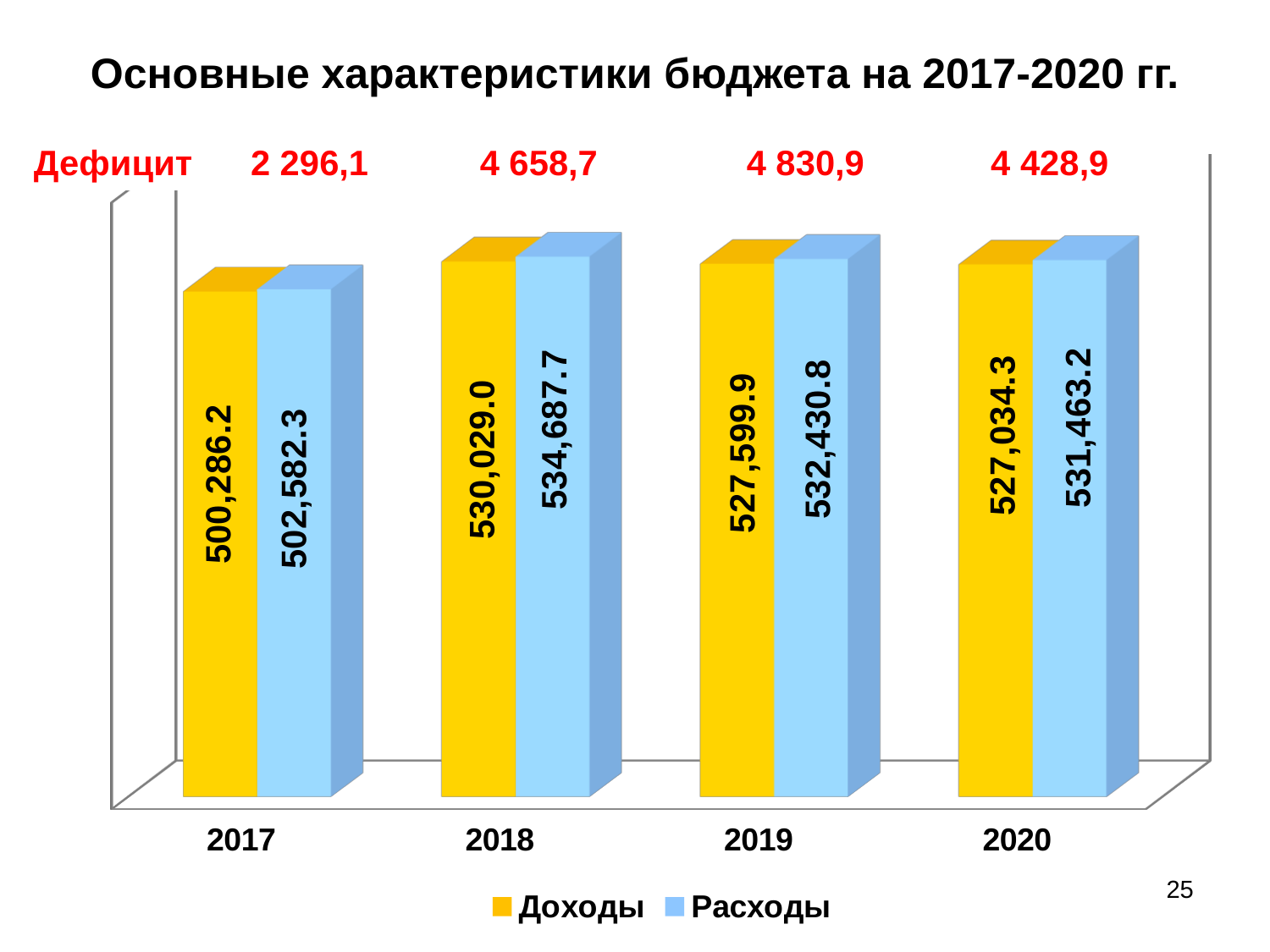
What is the value of Доходы for 2017? 500,286.2 In which year is Доходы lowest? 2017 How many years are shown on the x axis? 4 What is the difference between Расходы and Доходы in 2018? 4,658.7 What is the value of Расходы for 2018? 534,687.7 What kind of chart is shown on the slide? Bar chart What is the value of Доходы for 2020? 527,034.3 In which year is Расходы highest? 2018 What is the value of Расходы for 2019? 532,430.8 What is the Дефицит value shown for 2019? 4 830,9 Which is larger in 2019, Доходы or Расходы? Расходы How many series does the legend list? 2